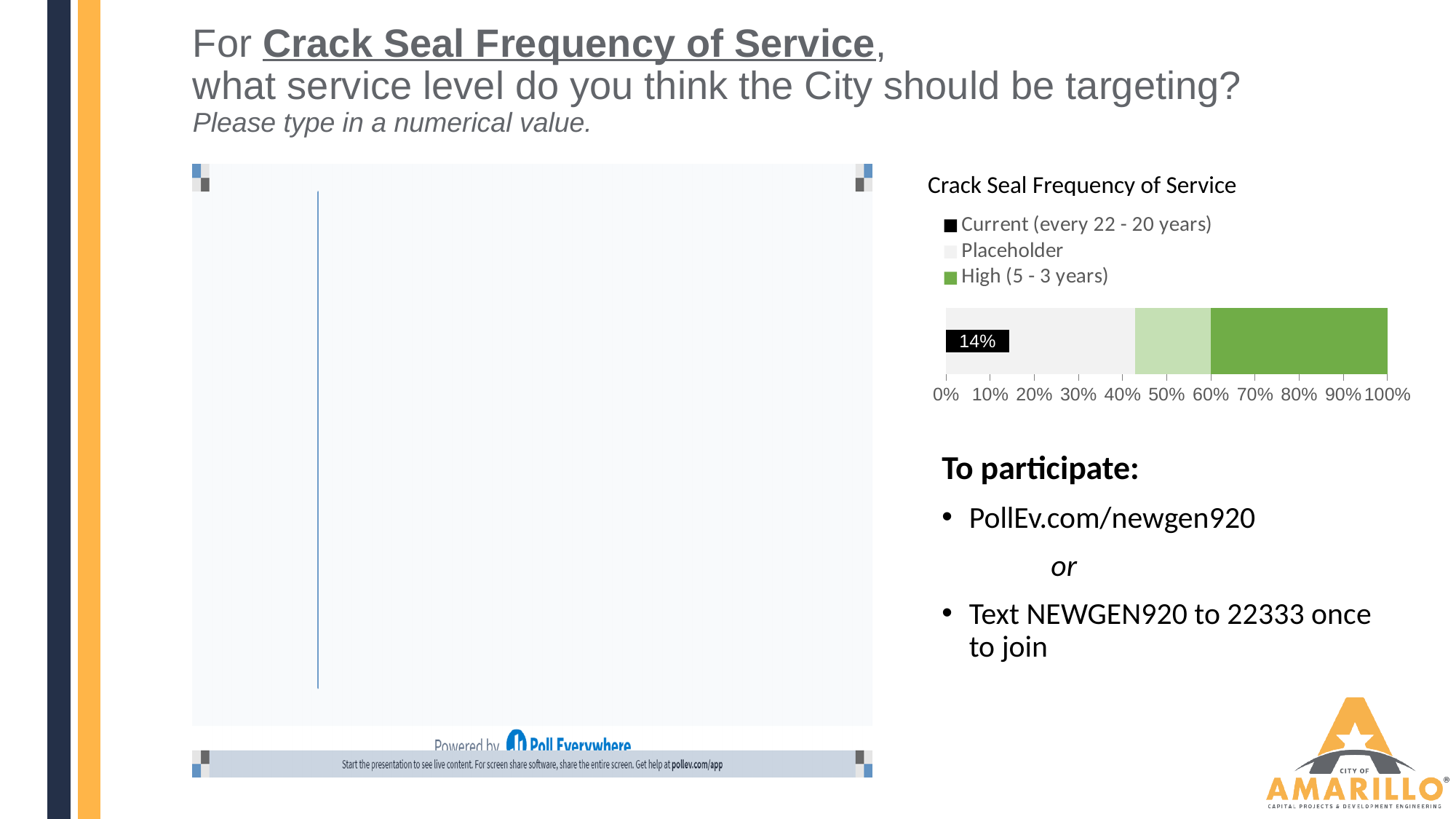
What is the title of the chart on the right side of the slide? Crack Seal Frequency of Service In the 'Crack Seal Frequency of Service' chart, what is the first legend entry? Current (every 22 - 20 years) What data label is printed on the bar in the 'Crack Seal Frequency of Service' chart? 14% In the 'Crack Seal Frequency of Service' chart, is the printed value 14% greater or less than 20%? less In the 'Crack Seal Frequency of Service' chart, is the printed value 14% greater or less than 10%? greater What kind of chart is shown under the title 'Crack Seal Frequency of Service'? bar chart How many series does the legend of the 'Crack Seal Frequency of Service' chart list? 3 What is the highest value shown on the x axis of the 'Crack Seal Frequency of Service' chart? 100%